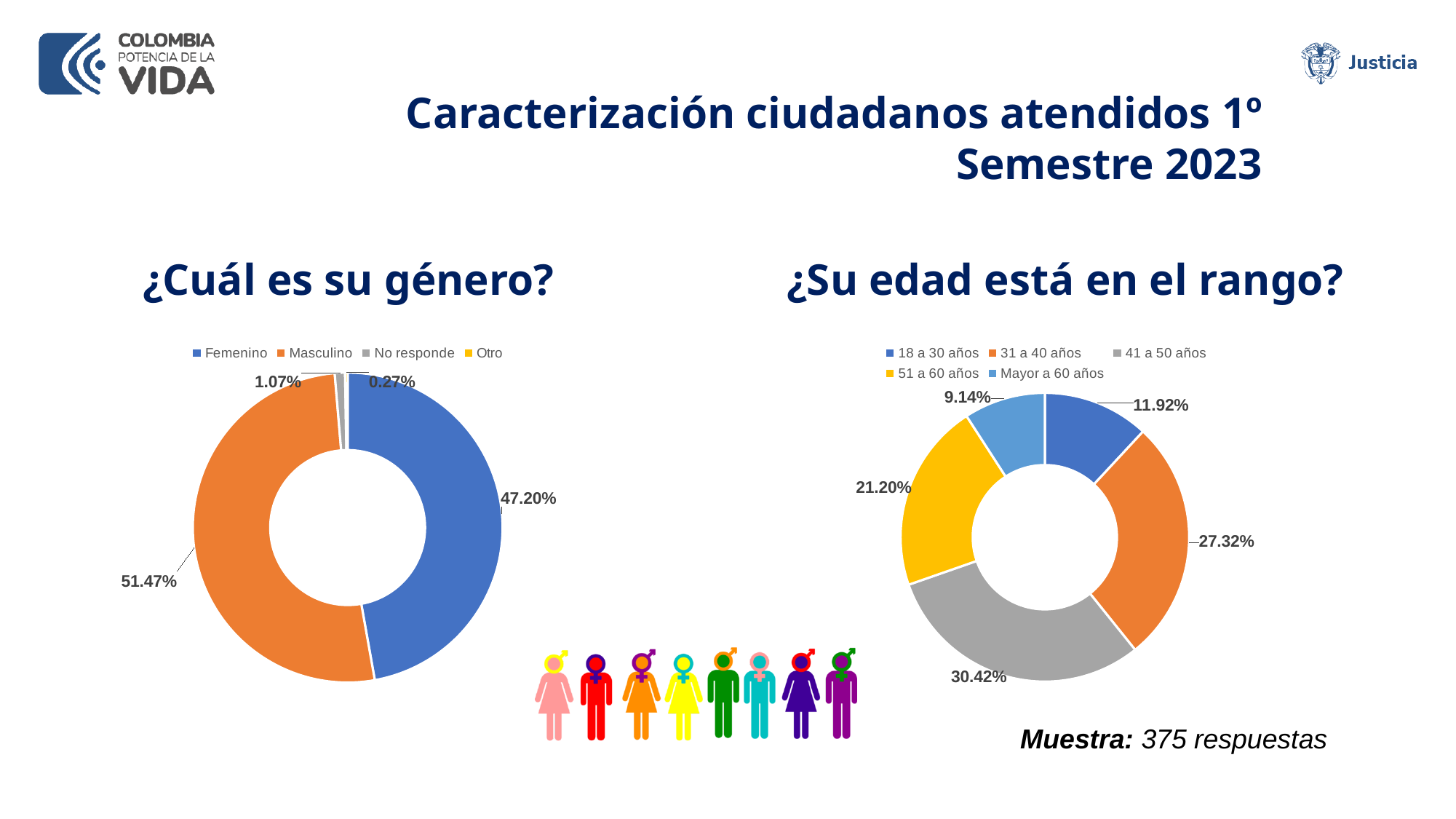
In the chart titled "¿Su edad está en el rango?", which is larger: 31 a 40 años or 51 a 60 años? 31 a 40 años In the chart titled "¿Cuál es su género?", how many categories does the legend list? 4 In the chart titled "¿Su edad está en el rango?", how many age ranges does the legend list? 5 What kind of chart is used for "¿Cuál es su género?"? Doughnut chart In the chart titled "¿Cuál es su género?", what is the difference between the Masculino and Femenino percentages? 4.27% In the chart titled "¿Cuál es su género?", which category has the largest share? Masculino In the chart titled "¿Su edad está en el rango?", what percentage is shown for 41 a 50 años? 30.42% In the chart titled "¿Su edad está en el rango?", which age range has the smallest share? Mayor a 60 años In the chart titled "¿Su edad está en el rango?", what is the difference between the 41 a 50 años and 18 a 30 años percentages? 18.50% In the chart titled "¿Cuál es su género?", what percentage is shown for Masculino? 51.47% In the chart titled "¿Cuál es su género?", what percentage is shown for Femenino? 47.20% In the chart titled "¿Su edad está en el rango?", what percentage is shown for Mayor a 60 años? 9.14%